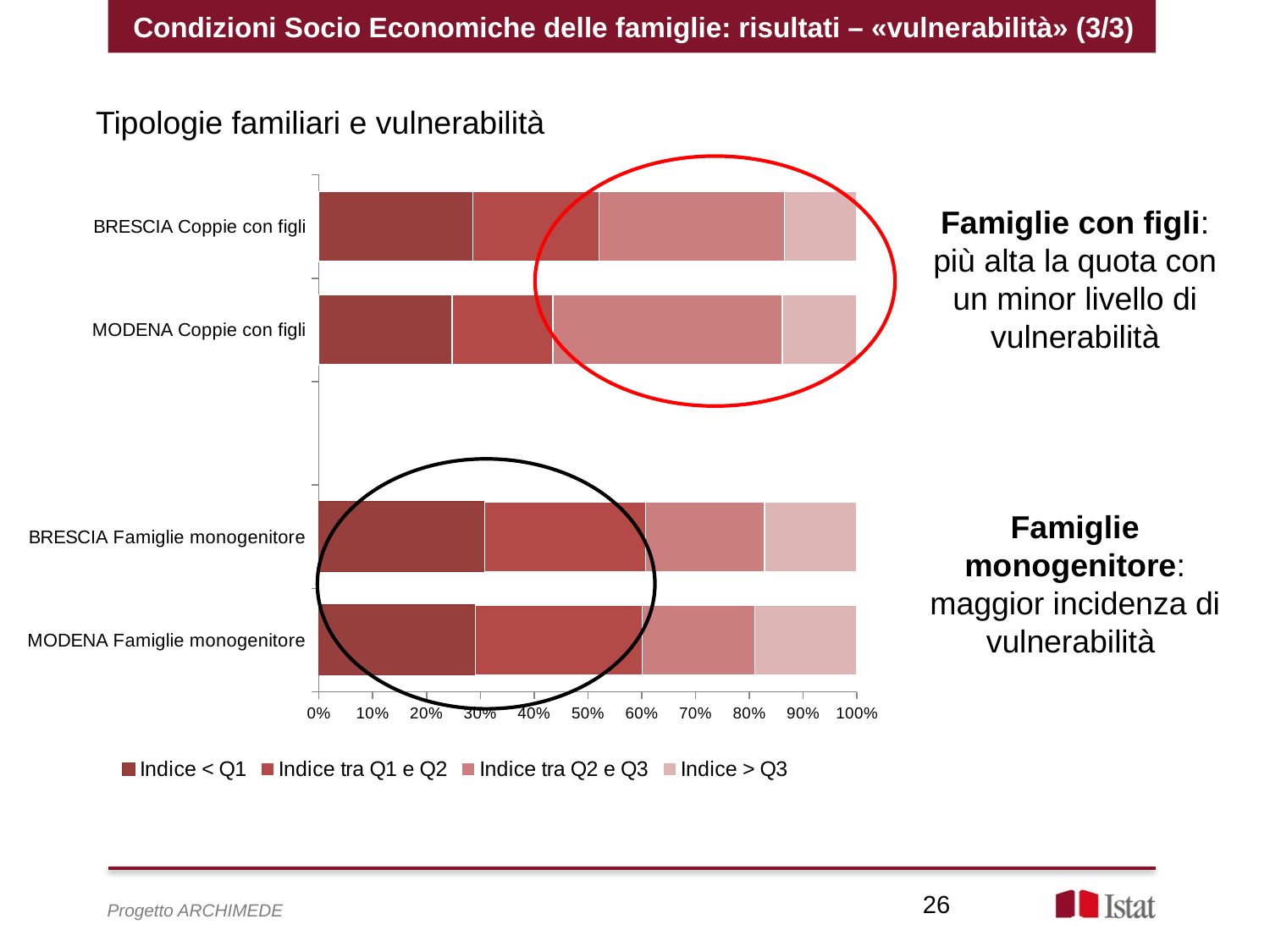
What kind of chart is shown on the slide? Stacked bar chart Is the "Indice tra Q2 e Q3" share for MODENA Famiglie monogenitore greater or less than 30%? less Is the "Indice tra Q2 e Q3" share for MODENA Coppie con figli greater or less than 30%? greater What is the title shown above the chart? Tipologie familiari e vulnerabilità Which has the larger "Indice tra Q2 e Q3" share: MODENA Coppie con figli or MODENA Famiglie monogenitore? MODENA Coppie con figli How many family-type categories are plotted on the chart? 4 What is the total of the stacked bar for BRESCIA Coppie con figli? 100% What is the first entry in the chart legend? Indice < Q1 Is the "Indice < Q1" share for MODENA Coppie con figli greater or less than 30%? less Which category has the largest "Indice tra Q2 e Q3" segment? MODENA Coppie con figli Which has the larger "Indice < Q1" share: BRESCIA Famiglie monogenitore or MODENA Coppie con figli? BRESCIA Famiglie monogenitore How many series does the chart legend list? 4